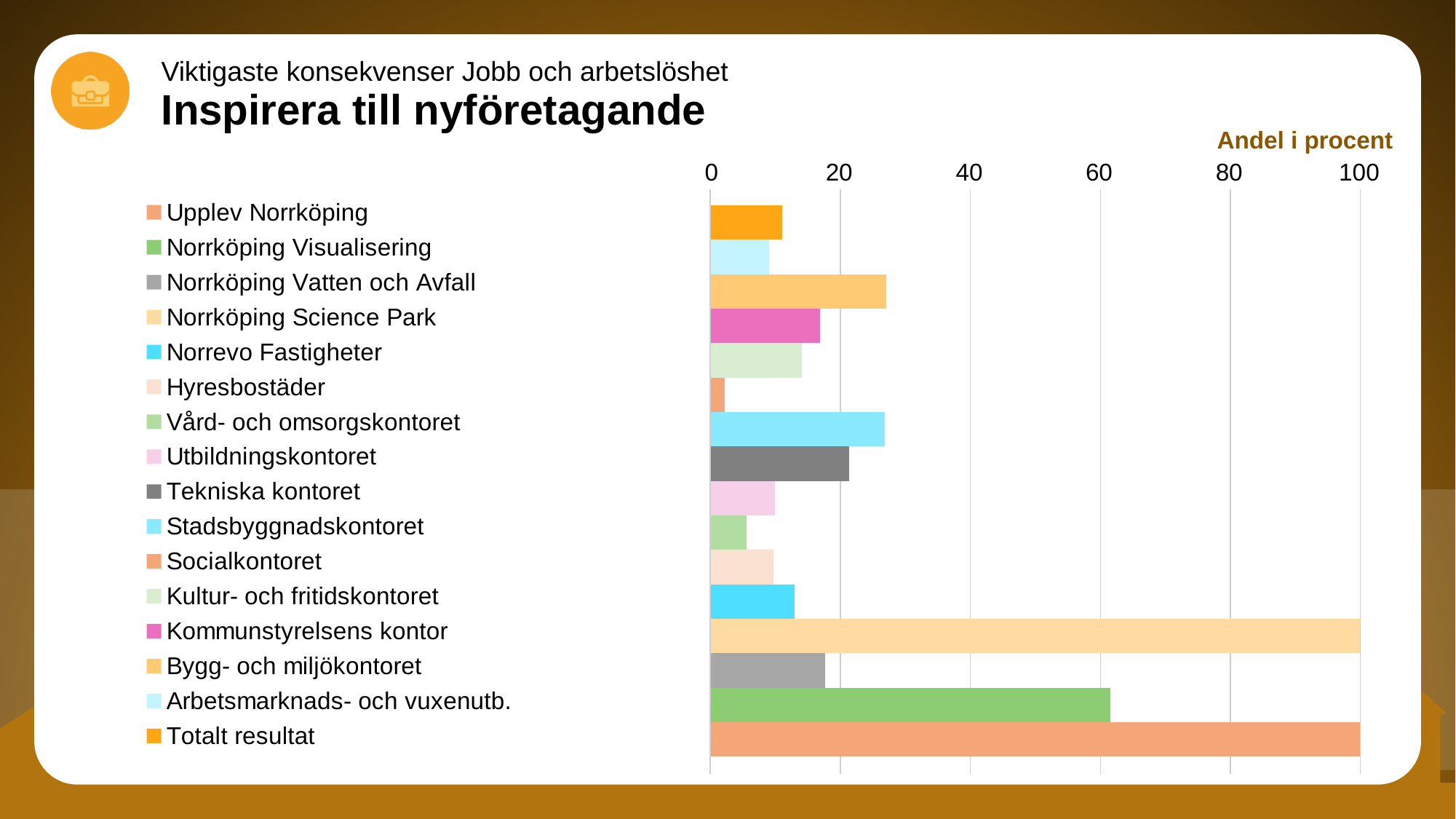
How many series does the legend list? 16 Is the value for Vård- och omsorgskontoret greater or less than 20? less Is the value for Tekniska kontoret greater or less than 40? less What kind of chart is shown on the slide? bar chart Is the value for Socialkontoret greater or less than 20? less How many bars are plotted in the chart? 16 Which is larger, the value for Norrköping Visualisering or the value for Bygg- och miljökontoret? Norrköping Visualisering Which is larger, the value for Stadsbyggnadskontoret or the value for Socialkontoret? Stadsbyggnadskontoret What label is shown above the horizontal axis of the chart? Andel i procent Which series has the lowest value in the chart? Socialkontoret